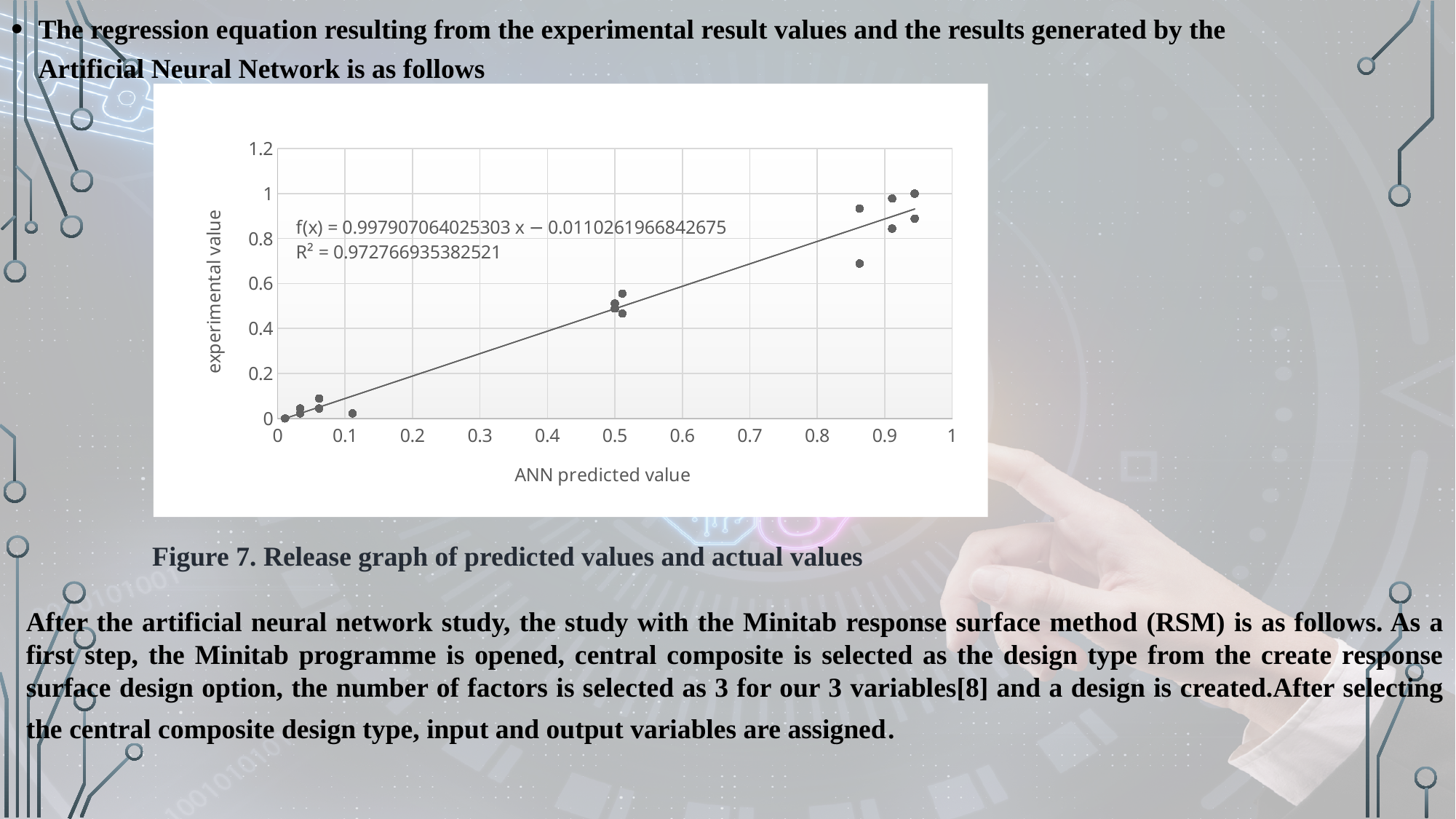
Are the experimental values for the points plotted near an ANN predicted value of 0 greater or less than 0.2? less Are the experimental values for the points plotted near an ANN predicted value of 0.5 greater or less than 0.6? less What is the slope of the trendline equation printed on the chart? 0.997907064025303 Are the experimental values for the points plotted near an ANN predicted value of 0.5 greater or less than 0.4? greater What is the label of the x axis of the chart? ANN predicted value What kind of chart is shown on the slide? scatter chart What is the intercept of the trendline equation printed on the chart? −0.0110261966842675 What is the label of the y axis of the chart? experimental value What is the R² value printed on the chart? 0.972766935382521 Do the plotted points rise or fall as the ANN predicted value increases along the x axis? rise What is the highest tick value shown on the y axis of the chart? 1.2